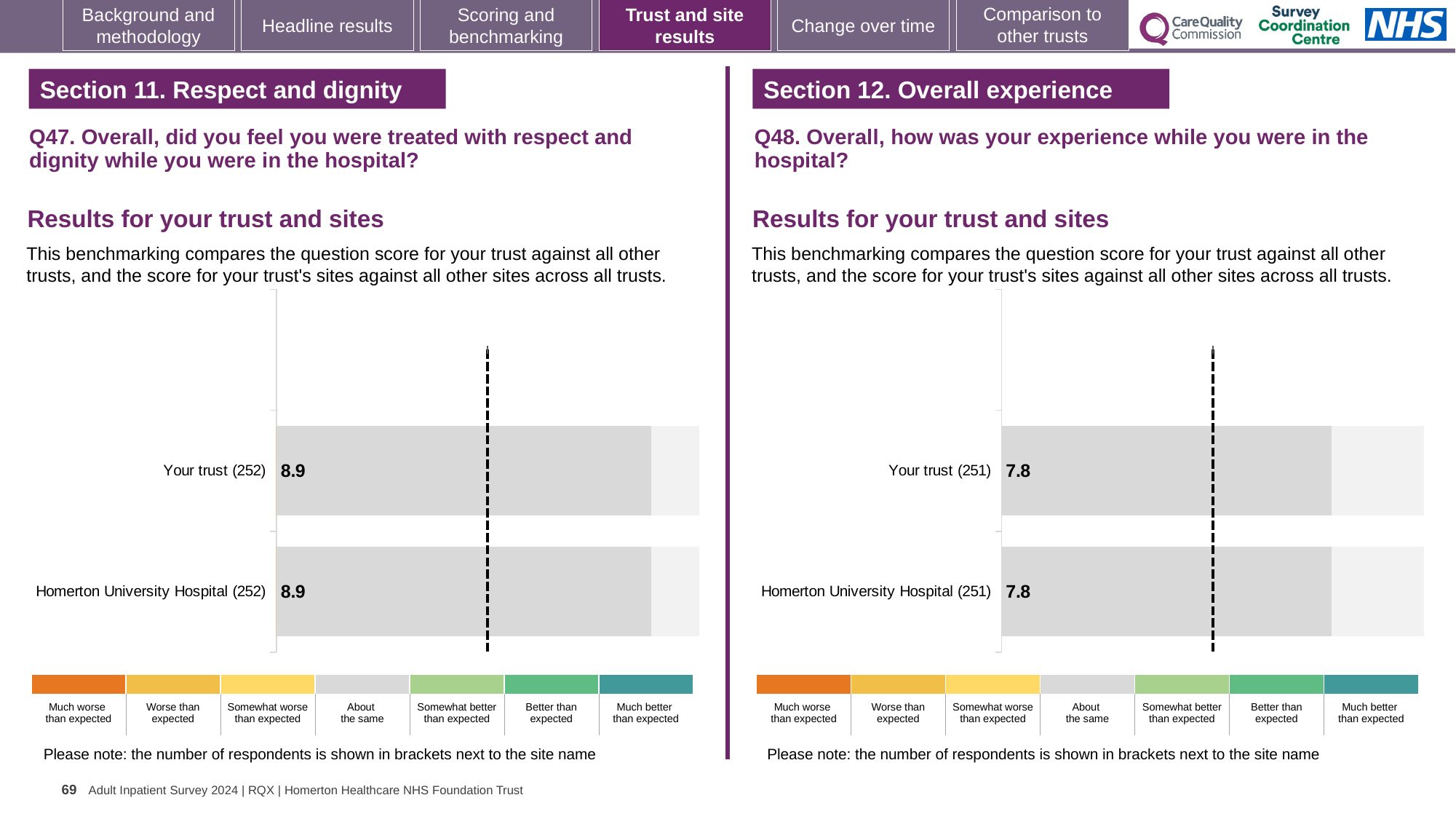
In the Q48 chart on the right, what is the score for Your trust? 7.8 Which is larger: the Your trust score in the Q47 chart on the left or the Your trust score in the Q48 chart on the right? Q47 chart (8.9) In the Q47 chart on the left, what is the score for Homerton University Hospital? 8.9 What kind of chart is used for the Q47 results on the left? Bar chart How many bars are plotted in the Q48 chart on the right? 2 How many respondents are shown in brackets for Your trust in the Q48 chart on the right? 251 How many bars are plotted in the Q47 chart on the left? 2 How many categories does the colour legend below the Q47 chart on the left list? 7 What is the difference between the Your trust score in the Q47 chart on the left and the Your trust score in the Q48 chart on the right? 1.1 In the Q47 chart on the left, is the score for Your trust higher or lower than the score for Homerton University Hospital? They are the same (8.9) In the Q47 chart on the left, what is the score for Your trust? 8.9 In the Q48 chart on the right, what is the score for Homerton University Hospital? 7.8